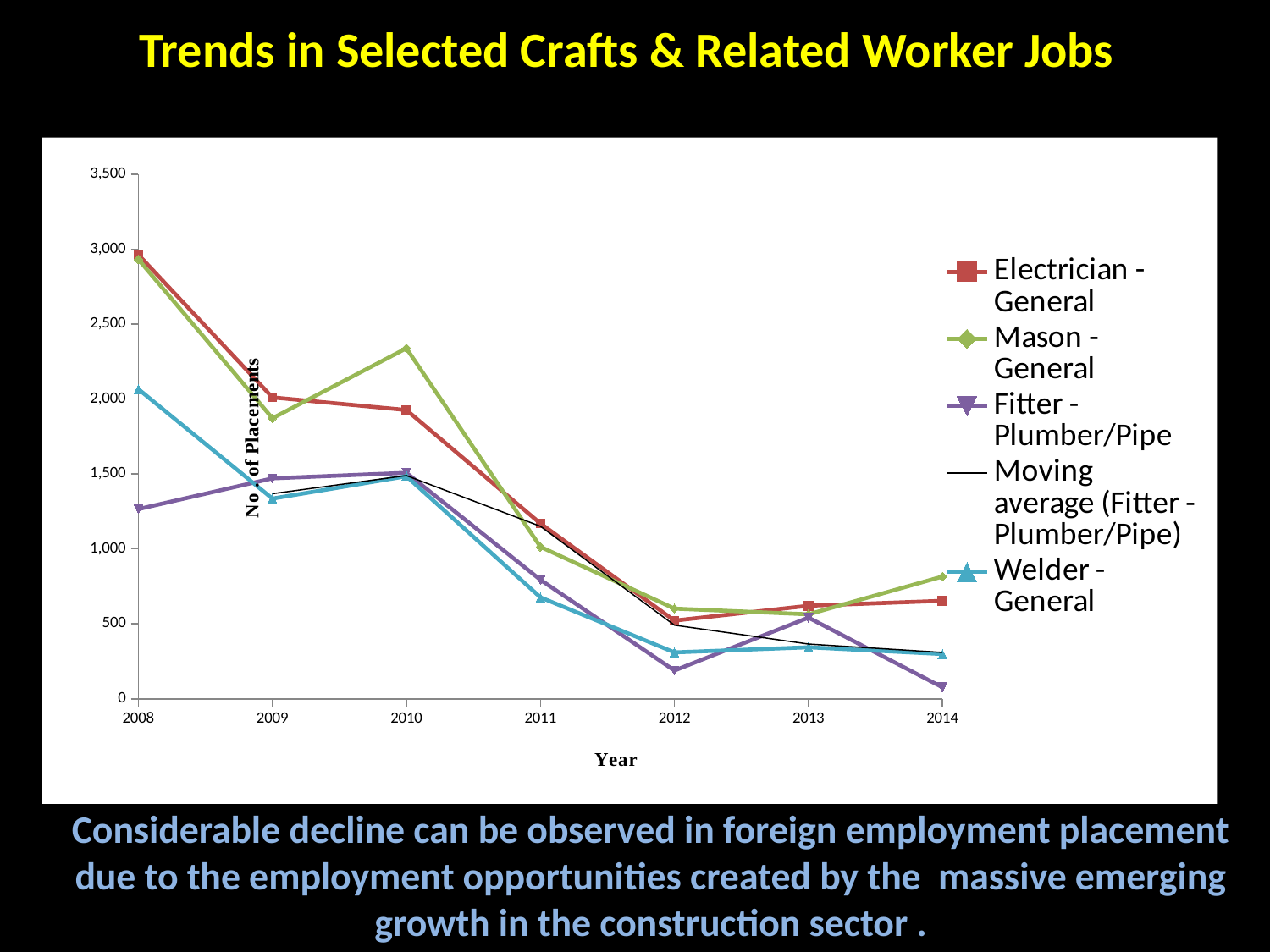
Is the value for Welder - General in 2008 greater or less than 1,500? greater How many series does the legend list? 5 Is the value for Electrician - General in 2008 greater or less than 2,500? greater Which series has the lowest value in 2008? Fitter - Plumber/Pipe What kind of chart is shown on the slide? Line chart Which series has the lowest value in 2014? Fitter - Plumber/Pipe In 2010, which is larger: Mason - General or Electrician - General? Mason - General How many years are shown on the x axis? 7 Do the values for Electrician - General rise or fall from 2008 to 2012? fall Is the value for Fitter - Plumber/Pipe in 2014 greater or less than 500? less In 2012, which is larger: Welder - General or Fitter - Plumber/Pipe? Welder - General Which series has the highest value in 2014? Mason - General